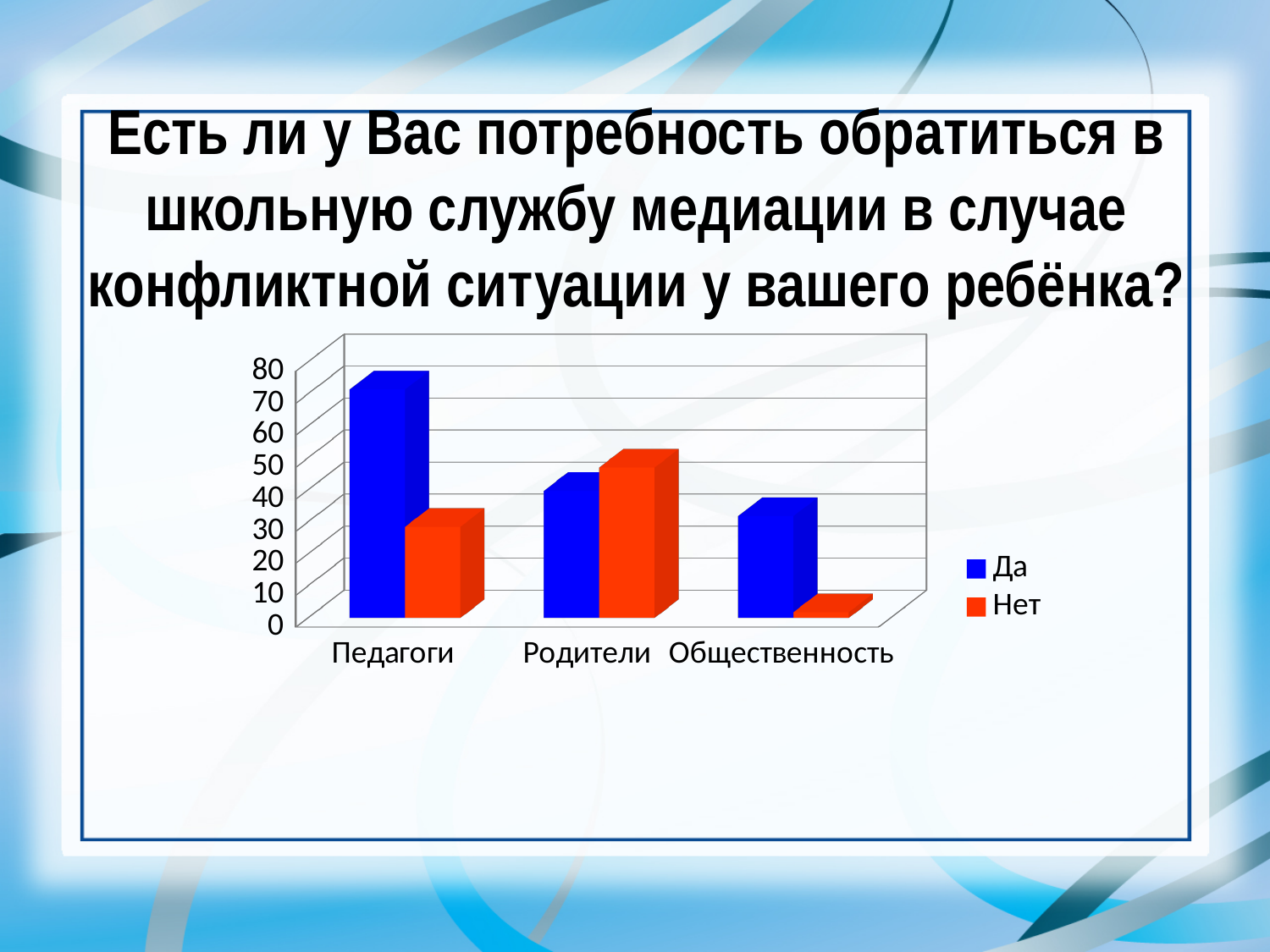
How many categories are shown on the x axis of the chart? 3 Which category has the highest value for the "Да" series? Педагоги What kind of chart is shown on the slide? bar chart Do the "Да" values rise or fall from "Педагоги" to "Общественность"? fall For the "Педагоги" category, which is larger: "Да" or "Нет"? Да Is the "Нет" value for "Общественность" greater or less than 10? less Which category has the highest value for the "Нет" series? Родители Is the "Да" value for "Педагоги" greater or less than 60? greater Which colour represents the "Нет" series in the chart? red Which category has the lowest value for the "Нет" series? Общественность For the "Родители" category, which is larger: "Да" or "Нет"? Нет How many series does the chart's legend list? 2